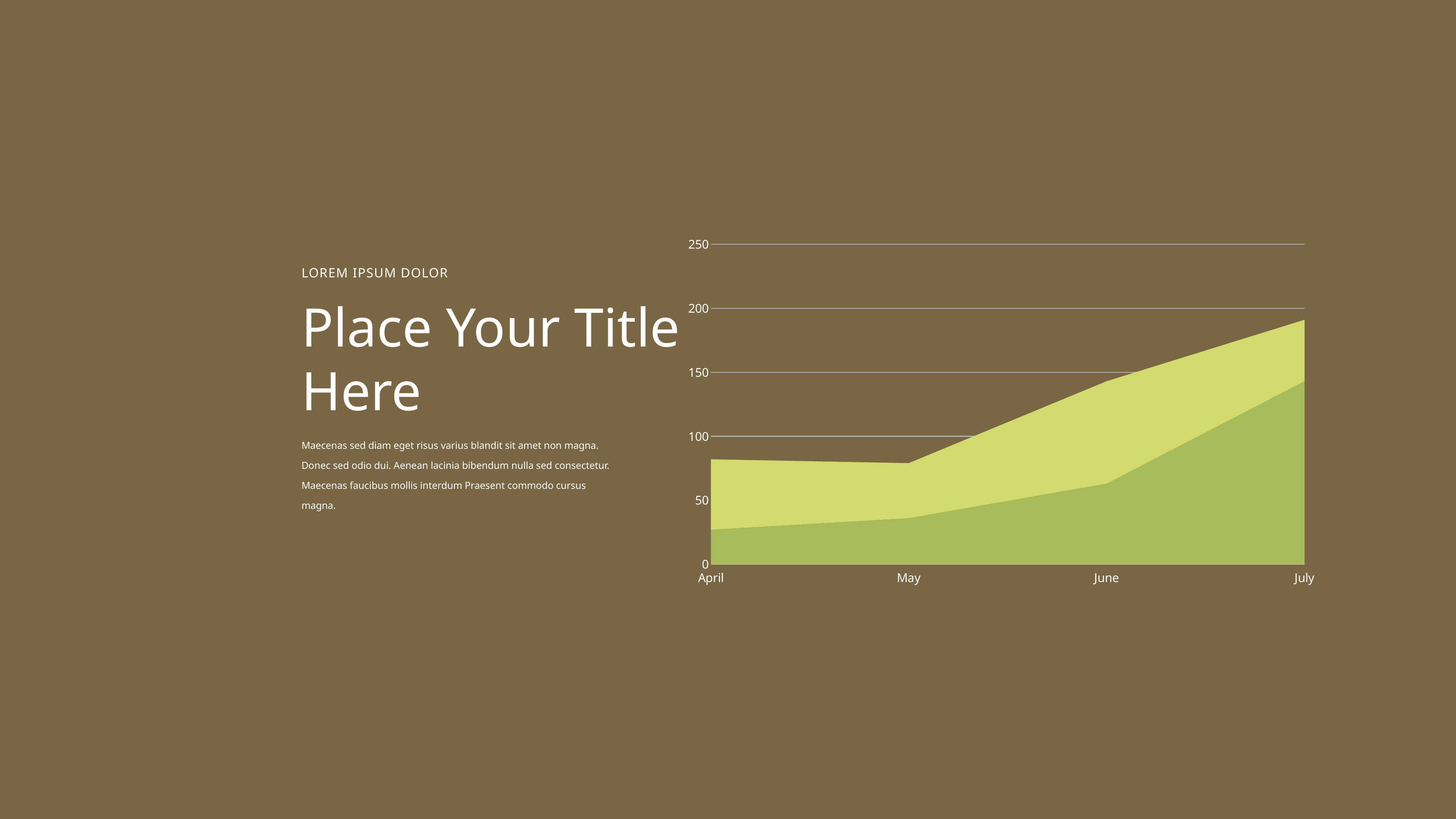
What kind of chart is shown on the slide? Area chart Which month has the lowest value for the darker green (lower) area? April Which month has the highest value for the darker green (lower) area? July Is the value of the lighter green (upper) area in April greater or less than 100? less What is the highest value labelled on the y axis of the chart? 250 How many months are shown on the x axis of the chart? 4 Which is larger for the lighter green (upper) area: the value in May or the value in June? June Is the value of the darker green (lower) area in May greater or less than 50? less Is the value of the darker green (lower) area in July greater or less than 100? greater Do the values of the darker green (lower) area rise or fall from April to July? rise